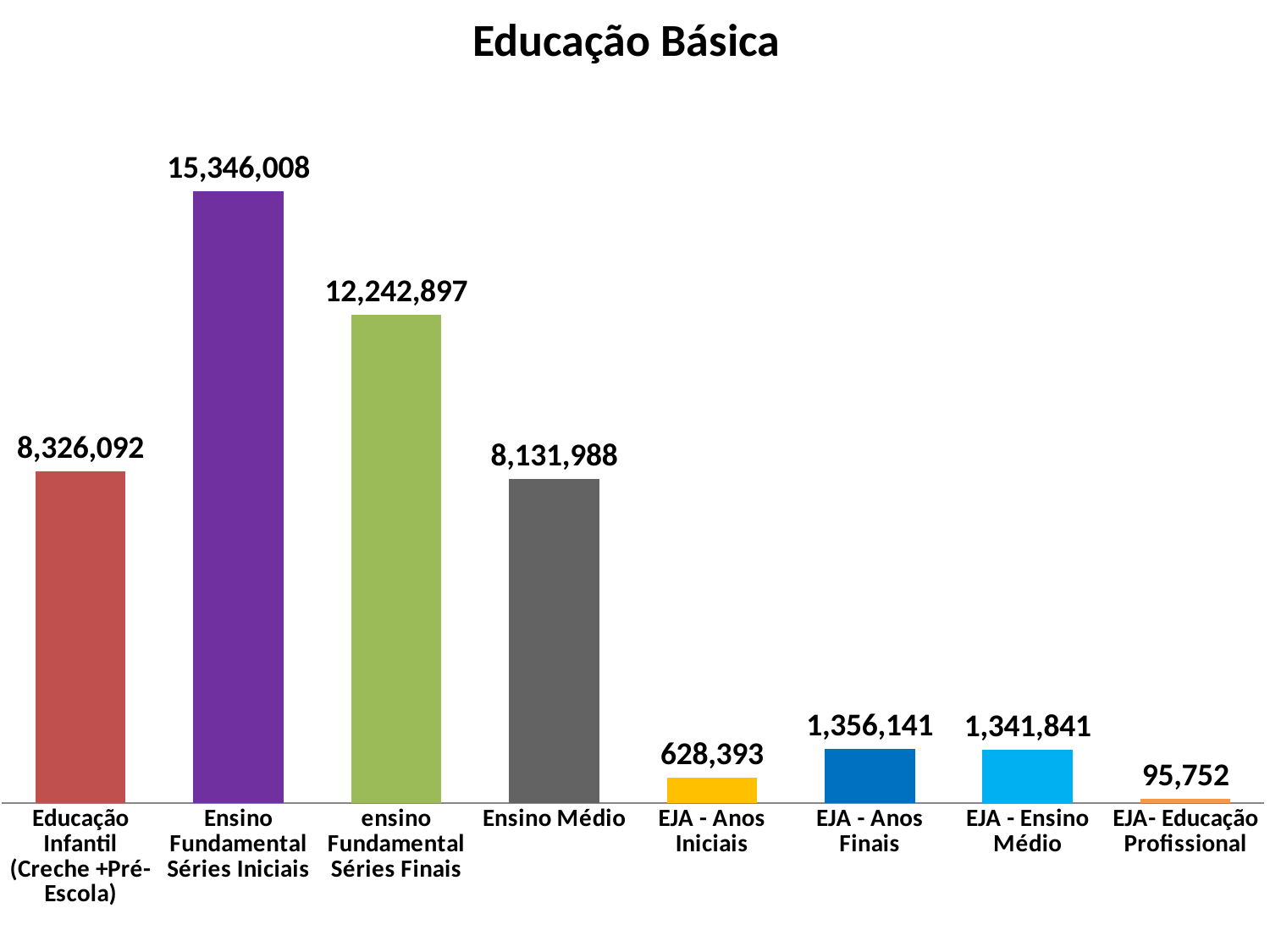
Which category has the highest value? Ensino Fundamental Séries Iniciais What is the title of the chart? Educação Básica Which is larger, EJA - Anos Finais or EJA - Ensino Médio? EJA - Anos Finais What is the difference between Educação Infantil and Ensino Médio? 194,104 Which category has the lowest value? EJA - Educação Profissional What is the value for Ensino Fundamental Séries Iniciais? 15,346,008 What is the difference between Ensino Fundamental Séries Iniciais and Ensino Fundamental Séries Finais? 3,103,111 How many categories are shown in the chart? 8 What kind of chart is this? Bar chart What is the value for Educação Infantil (Creche + Pré-Escola)? 8,326,092 What is the value for EJA - Educação Profissional? 95,752 What is the value for Ensino Médio? 8,131,988